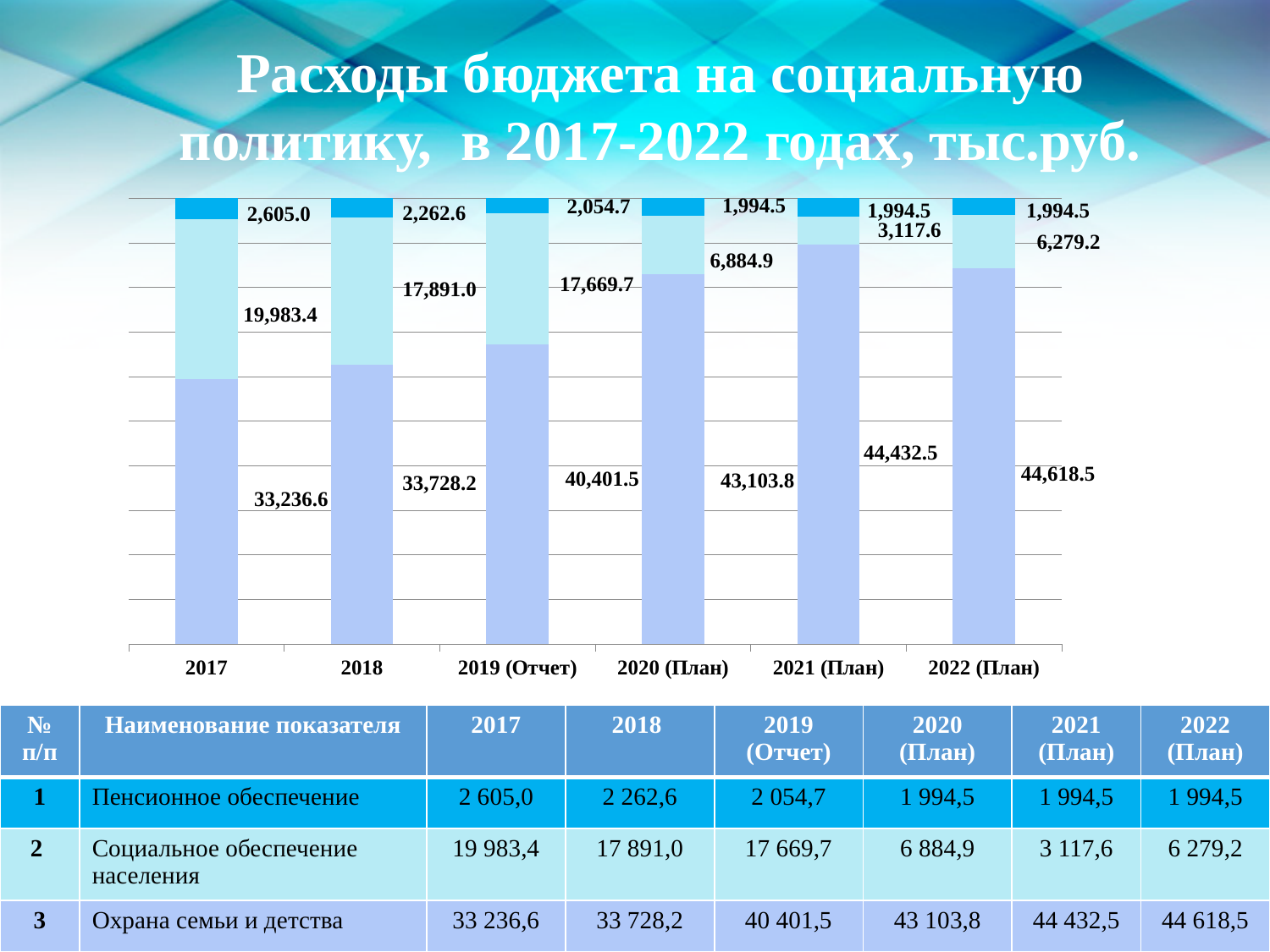
Do the values of the top segment (Пенсионное обеспечение) rise or fall from 2017 to 2022? fall Which is larger: the middle segment for 2020 (План) or the middle segment for 2022 (План)? 2020 (План) How many year categories are shown along the x axis of the chart? 6 What is the value of the bottom (largest) segment of the bar for 2017? 33,236.6 What is the value of the middle segment of the bar for 2021 (План)? 3,117.6 What is the total of the stacked bar for 2021 (План)? 49,544.6 In which year is the bottom segment (Охрана семьи и детства) the highest? 2022 (План) In which year is the middle segment (Социальное обеспечение населения) the lowest? 2021 (План) What is the total of the stacked bar for 2017? 55,825.0 What is the value of the top segment of the bar for 2018? 2,262.6 What is the difference between the bottom segment values for 2022 (План) and 2017? 11,381.9 What kind of chart is shown on the slide? bar chart